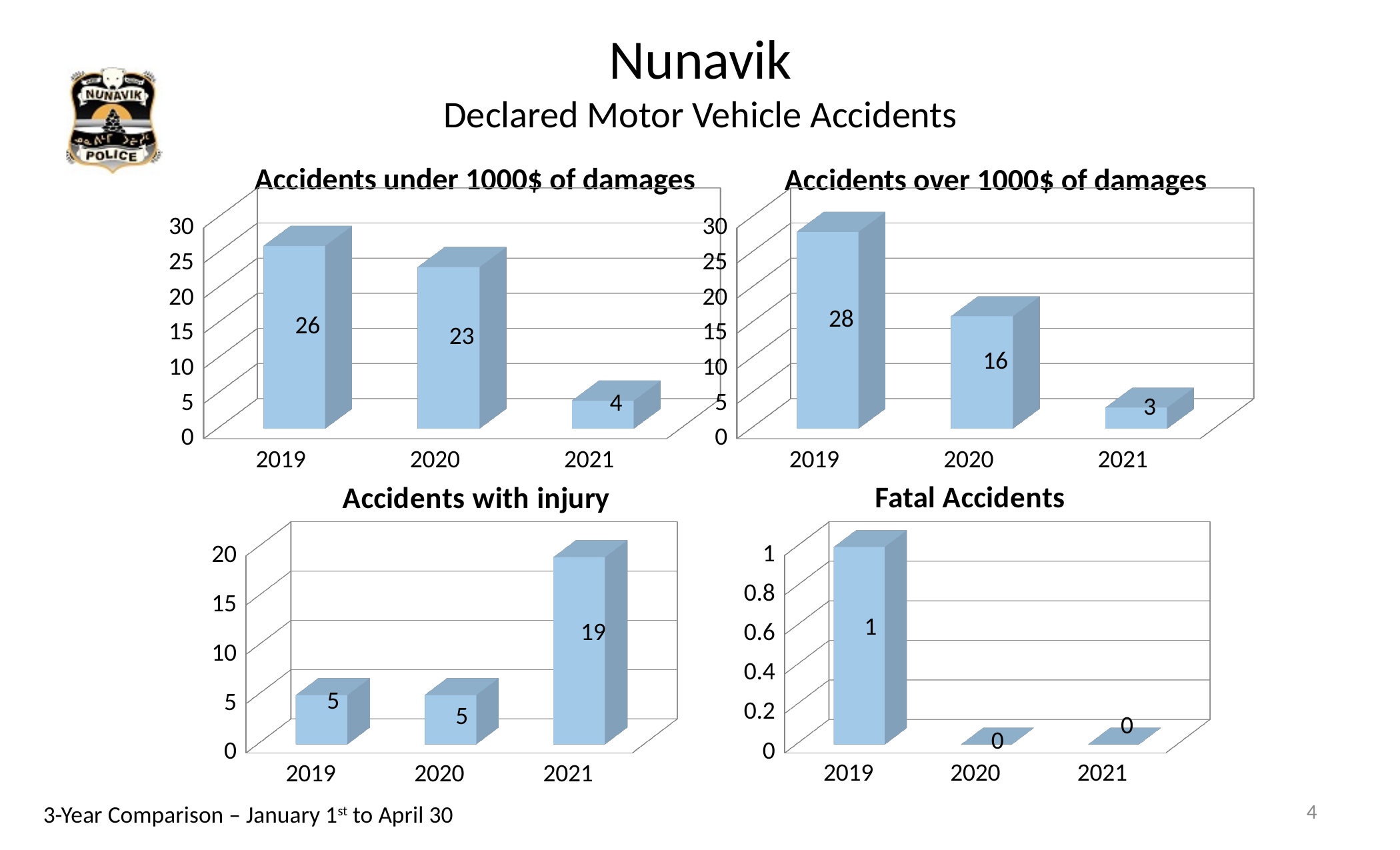
In the 'Accidents over 1000$ of damages' chart, which is larger, the value for 2019 or the value for 2020? 2019 In the 'Accidents under 1000$ of damages' chart, what is the difference between the 2019 and 2021 values? 22 In the 'Accidents with injury' chart, which year has the highest value? 2021 How many charts are shown on the slide? 4 In the 'Accidents over 1000$ of damages' chart, which year has the lowest value? 2021 In the 'Accidents with injury' chart, what is the difference between the 2021 and 2020 values? 14 In the 'Accidents over 1000$ of damages' chart, what is the value for 2020? 16 What kind of chart is the 'Fatal Accidents' chart? bar chart In the 'Fatal Accidents' chart, what is the value for 2019? 1 In the 'Accidents under 1000$ of damages' chart, what is the value for 2019? 26 In the 'Accidents with injury' chart, how many years are shown on the x axis? 3 In the 'Accidents under 1000$ of damages' chart, do the values rise or fall from 2019 to 2021? fall